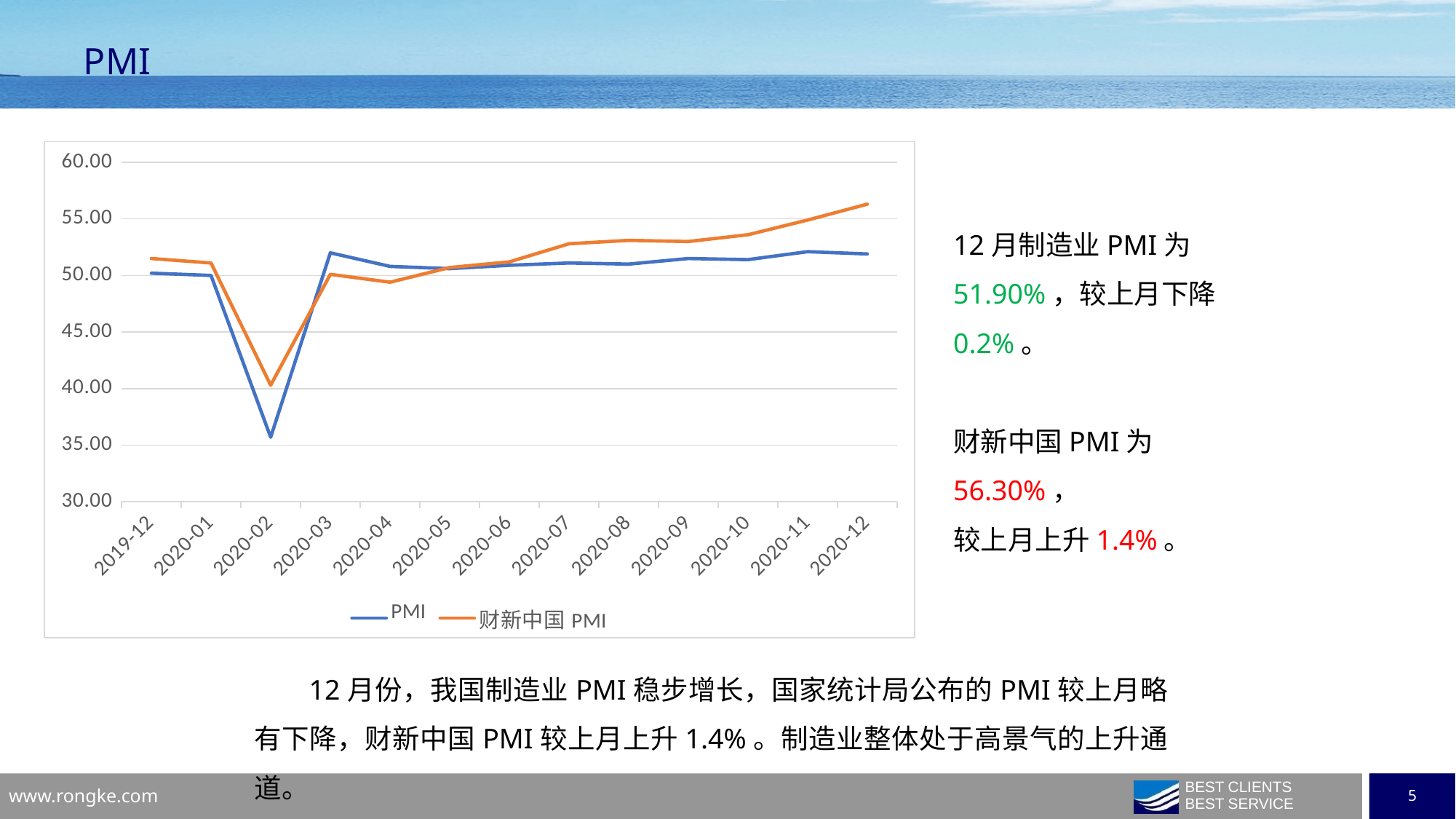
How many series does the chart legend list? 2 What colour is the line for the PMI series in the chart? blue In which month does the PMI series reach its lowest value? 2020-02 Is the value of the PMI series for 2020-02 greater or less than 40.00? less In which month does the 财新中国 PMI series reach its highest value? 2020-12 Does the 财新中国 PMI series rise or fall from 2020-03 to 2020-12? rise Is the value of the 财新中国 PMI series for 2020-12 greater or less than 55.00? greater How many time points are plotted along the x axis of the chart? 13 What kind of chart is shown on the slide? line chart At 2020-04, which series has the higher value, PMI or 财新中国 PMI? PMI In which month does the 财新中国 PMI series reach its lowest value? 2020-02 At 2020-02, which series has the higher value, PMI or 财新中国 PMI? 财新中国 PMI